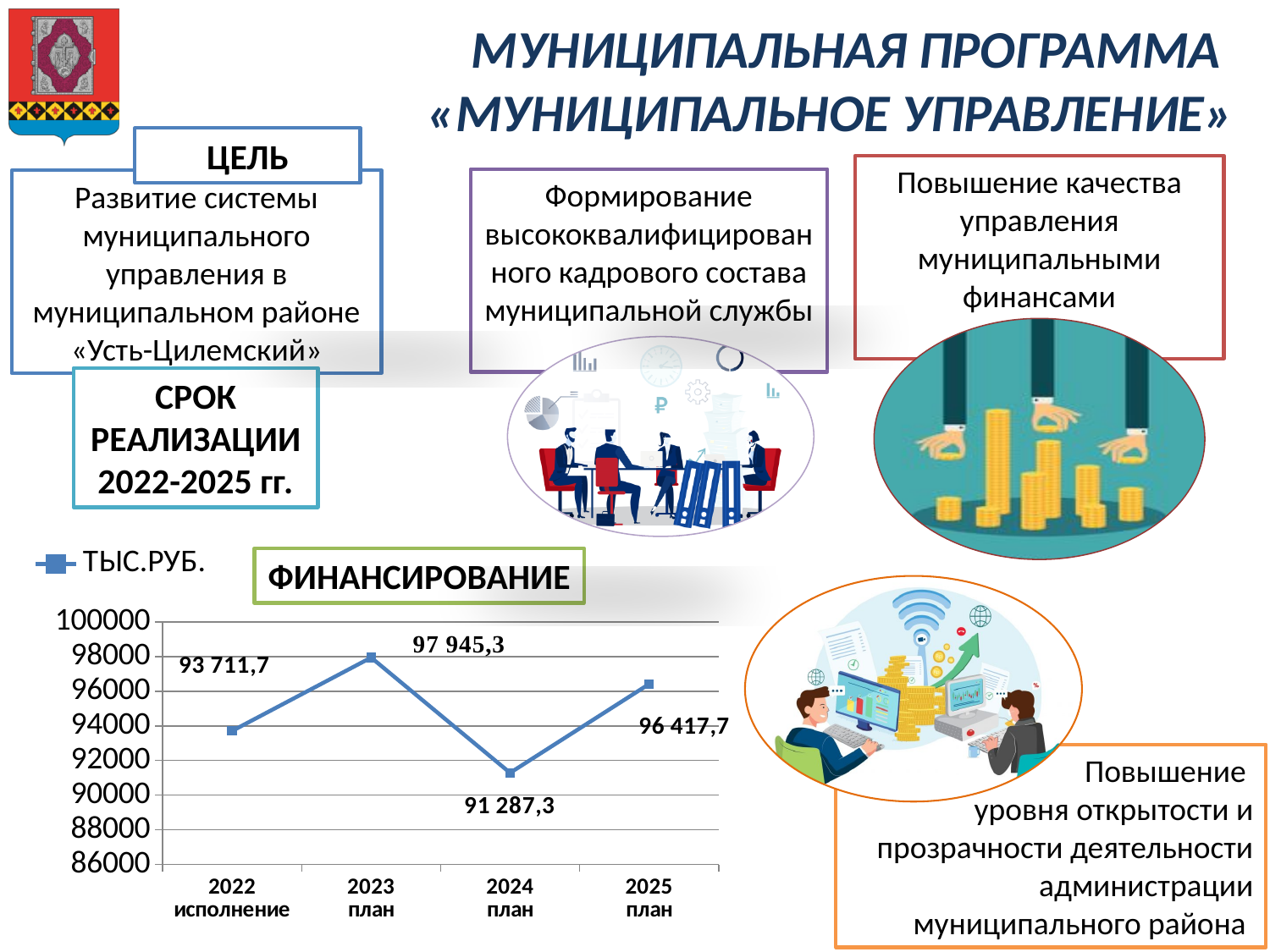
Is the value for 2024 план greater or less than 92000? less Which is larger, the value for 2022 исполнение or the value for 2025 план? 2025 план What is the difference between the values for 2023 план and 2024 план? 6 658,0 Which year has the highest value? 2023 план What is the value for 2024 план? 91 287,3 Which year has the lowest value? 2024 план What is the value for 2025 план? 96 417,7 What unit does the chart legend show? ТЫС.РУБ. What is the value for 2022 исполнение? 93 711,7 What type of chart is shown on the slide? line chart How many data points are plotted on the chart? 4 What is the value for 2023 план? 97 945,3